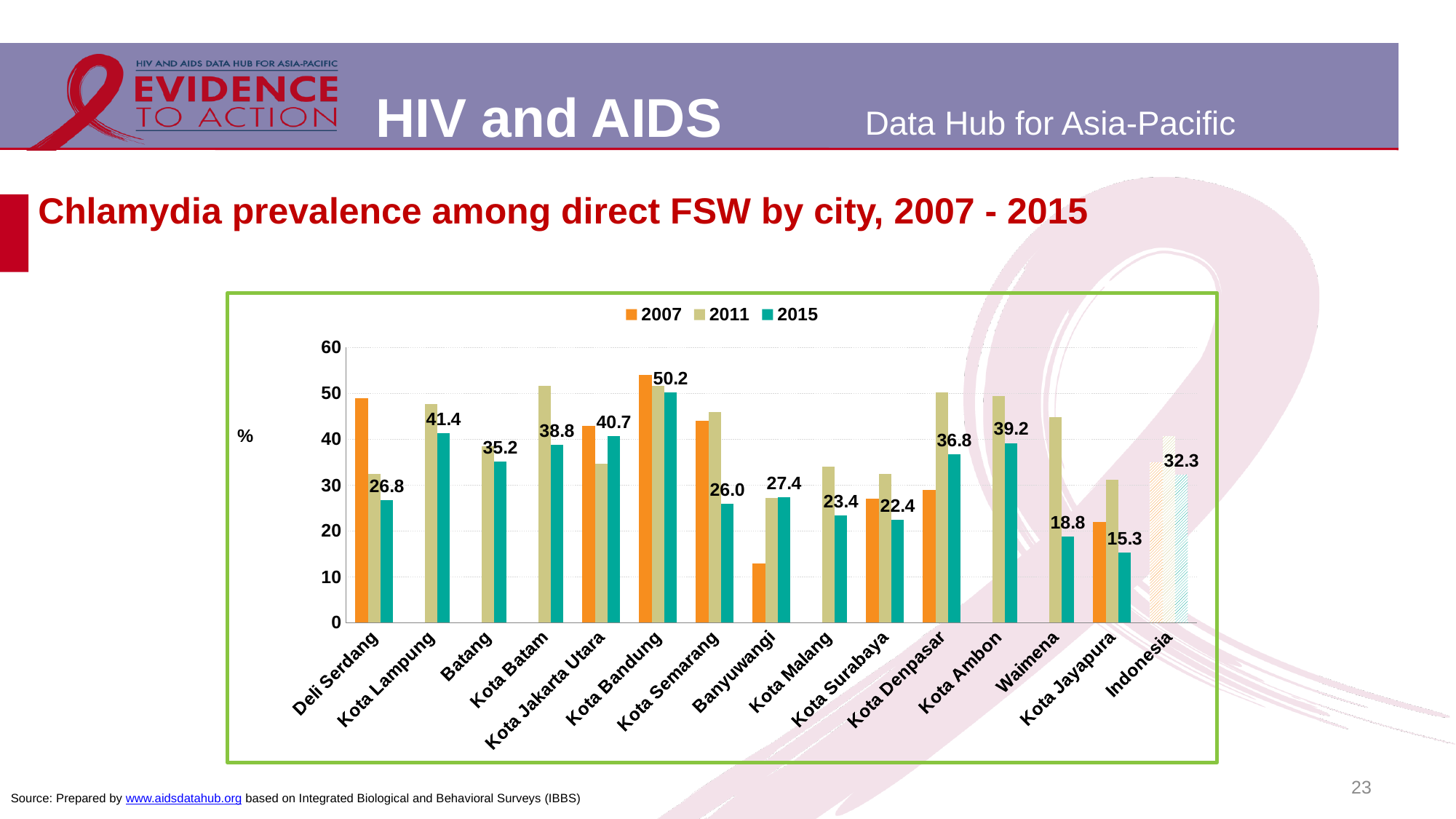
Which has the larger 2015 value, Kota Ambon or Kota Denpasar? Kota Ambon Which city has the highest 2015 value? Kota Bandung What is the 2015 value for Kota Jayapura? 15.3 How many cities/categories are shown on the x axis? 15 What type of chart is shown on the slide? Bar chart Which city has the lowest 2015 value? Kota Jayapura Is the 2007 value for Kota Bandung greater or less than 50? greater What is the 2015 chlamydia prevalence among direct FSW in Kota Bandung? 50.2 What is the difference between the 2015 values for Kota Bandung and Kota Jayapura? 34.9 What is the 2015 value for Indonesia? 32.3 Is the 2007 value for Banyuwangi greater or less than 20? less How many series does the legend list? 3